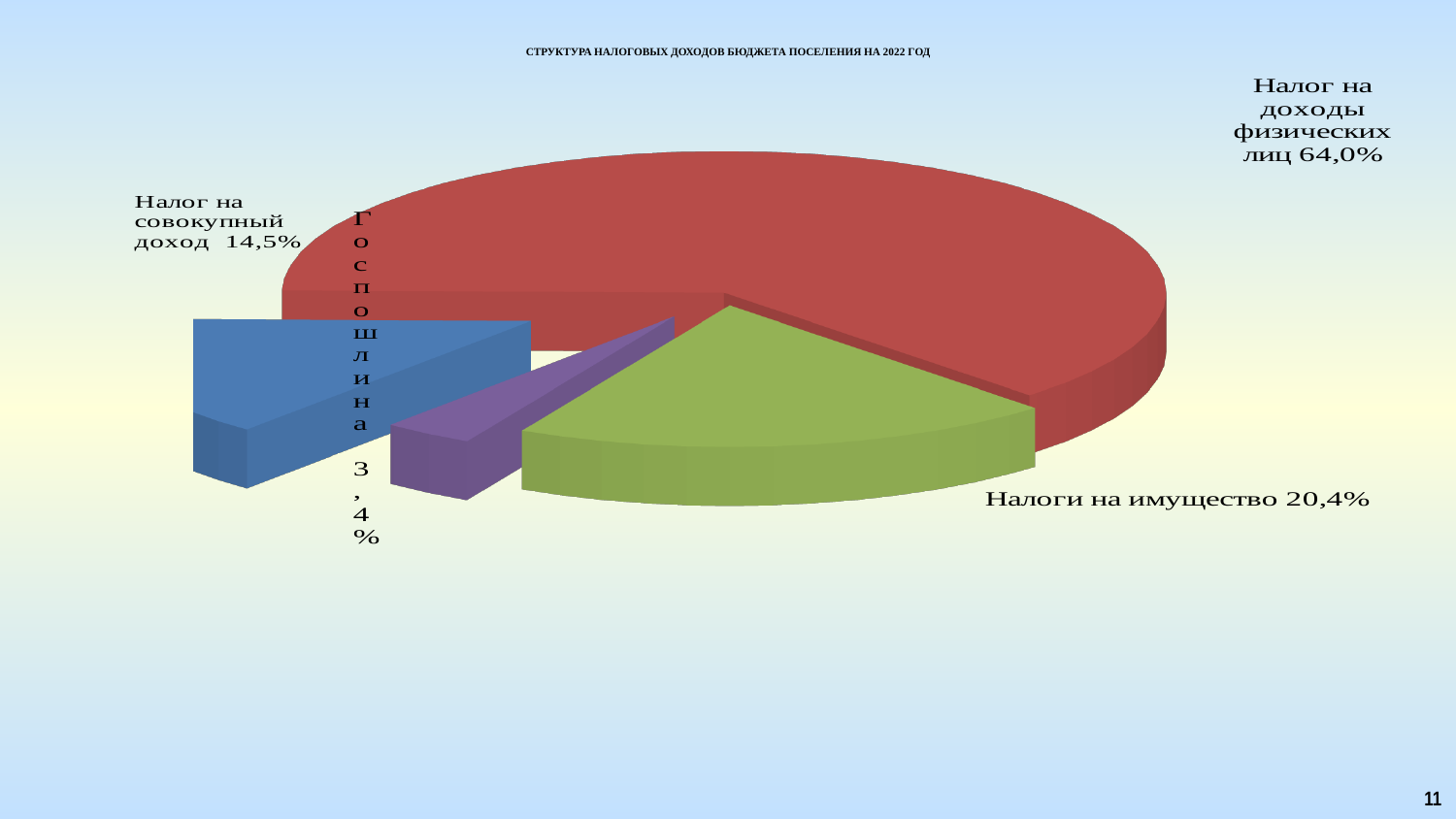
What is the difference in percentage points between Налог на доходы физических лиц and Налоги на имущество? 43,6 What kind of chart is shown on the slide? Pie chart How many slices does the pie chart have? 4 What is the share for Налог на совокупный доход? 14,5% Which category has the smallest slice of the pie? Госпошлина What colour is the slice for Налоги на имущество? Green Which category has the largest slice of the pie? Налог на доходы физических лиц What is the share for Налог на доходы физических лиц? 64,0% What is the title of the chart? СТРУКТУРА НАЛОГОВЫХ ДОХОДОВ БЮДЖЕТА ПОСЕЛЕНИЯ НА 2022 ГОД Which is larger, Налоги на имущество or Налог на совокупный доход? Налоги на имущество What is the share for Госпошлина? 3,4% What is the share for Налоги на имущество? 20,4%